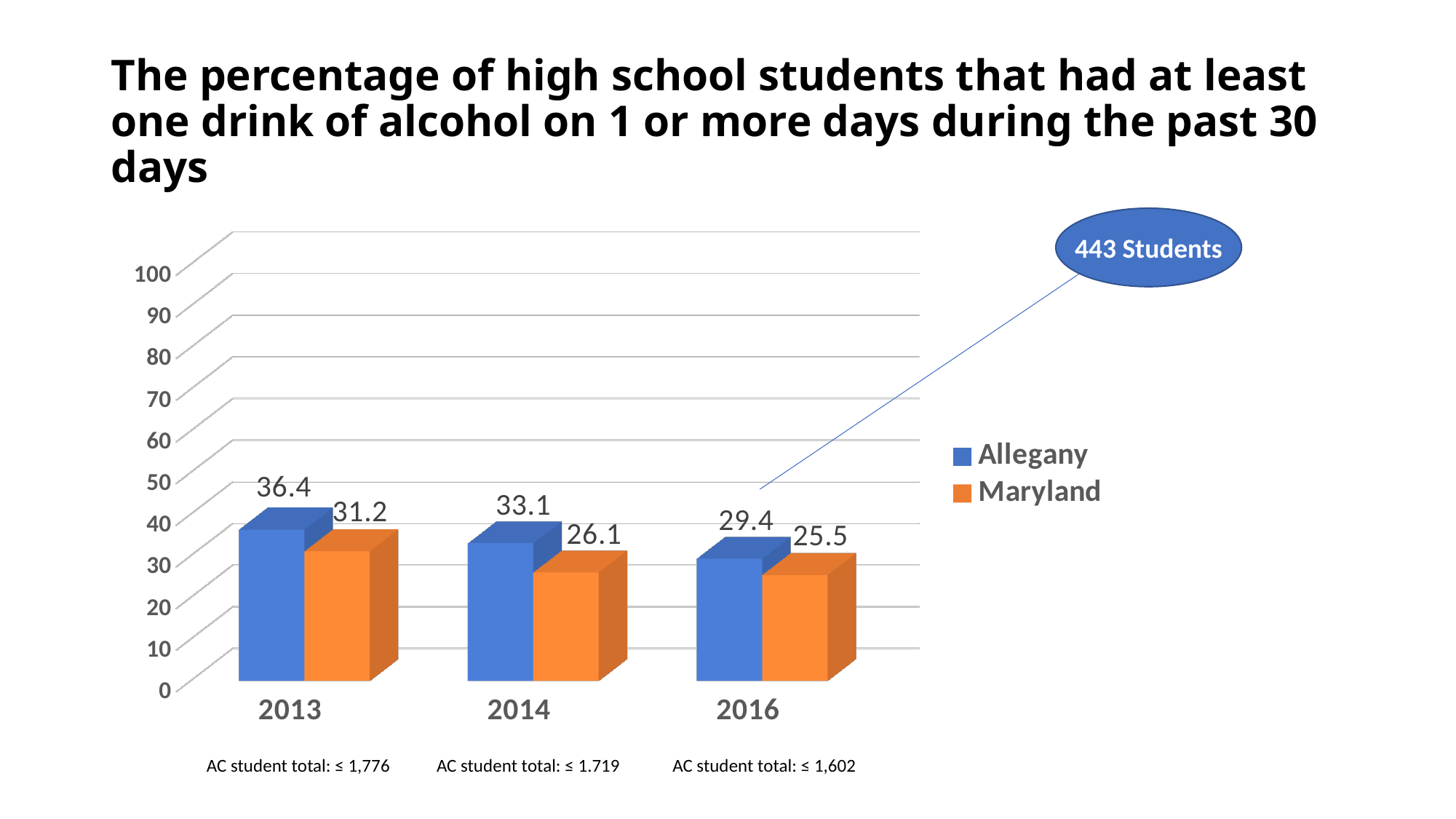
Which is larger in 2014, the Allegany value or the Maryland value? Allegany What is the value for Maryland in 2016? 25.5 What kind of chart is shown on the slide? Bar chart What is the value for Allegany in 2016? 29.4 Which year has the lowest value for Maryland? 2016 What is the value for Allegany in 2013? 36.4 Do the Allegany values rise or fall from 2013 to 2016? Fall Which year has the highest value for Allegany? 2013 How many series does the legend list? 2 What is the difference between the Allegany and Maryland values in 2013? 5.2 How many years are shown on the x axis? 3 What is the value for Maryland in 2014? 26.1